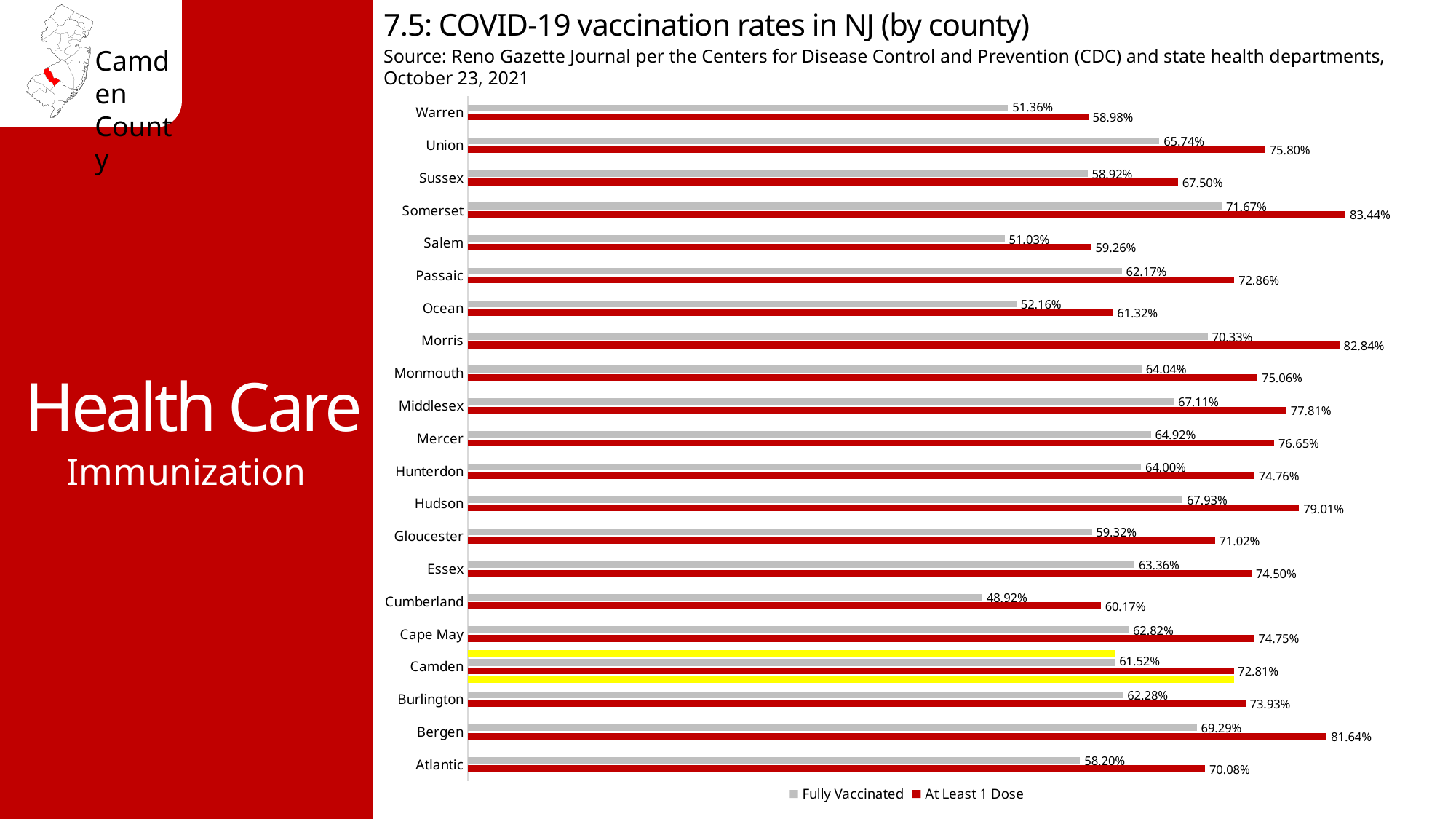
Which county has the lowest At Least 1 Dose rate? Warren Which county has the highest Fully Vaccinated rate? Somerset How many counties are shown in the chart? 21 What is the At Least 1 Dose rate for Cumberland County? 60.17% Which county has a higher Fully Vaccinated rate, Morris or Bergen? Morris Which series is shown in red in the chart? At Least 1 Dose What is the difference between Camden County's At Least 1 Dose rate and its Fully Vaccinated rate? 11.29 percentage points How many series does the legend list? 2 What type of chart is shown on the slide? Bar chart What is the At Least 1 Dose rate for Somerset County? 83.44% What is the Fully Vaccinated rate for Camden County? 61.52% Which county has the lowest Fully Vaccinated rate? Cumberland